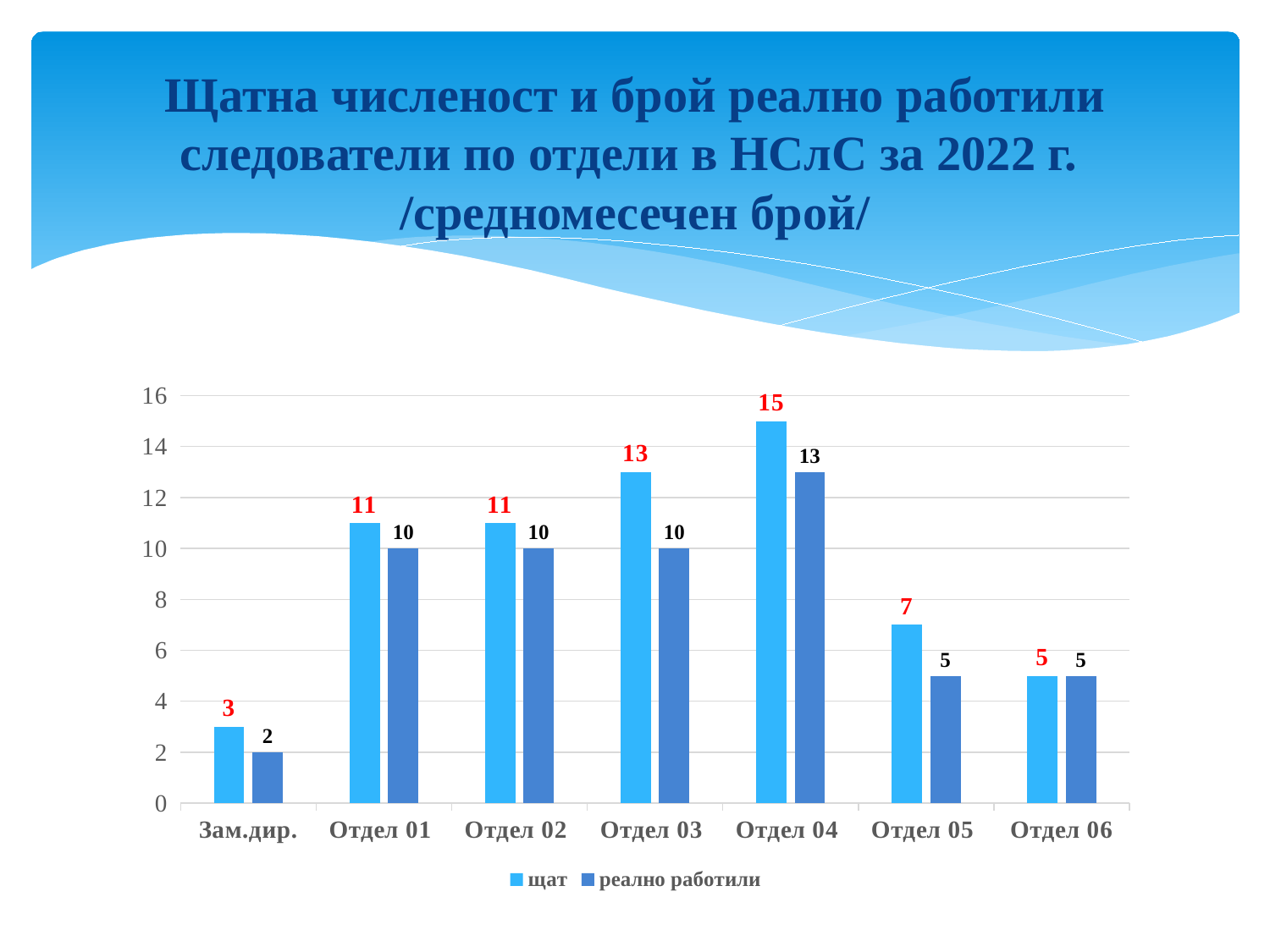
How many series does the legend list? 2 What is the value of "реално работили" for Отдел 06? 5 What is the difference between "щат" and "реално работили" for Отдел 05? 2 Which category has the lowest "реално работили" value? Зам.дир. What is the difference in "щат" between Отдел 04 and Зам.дир.? 12 What are the two series named in the legend? щат and реално работили Which category has the highest "щат" value? Отдел 04 How many categories are shown on the x axis? 7 What is the value of "реално работили" for Зам.дир.? 2 Which is larger for Отдел 03: "щат" or "реално работили"? щат What is the value of "щат" for Отдел 04? 15 What kind of chart is shown on the slide? bar chart